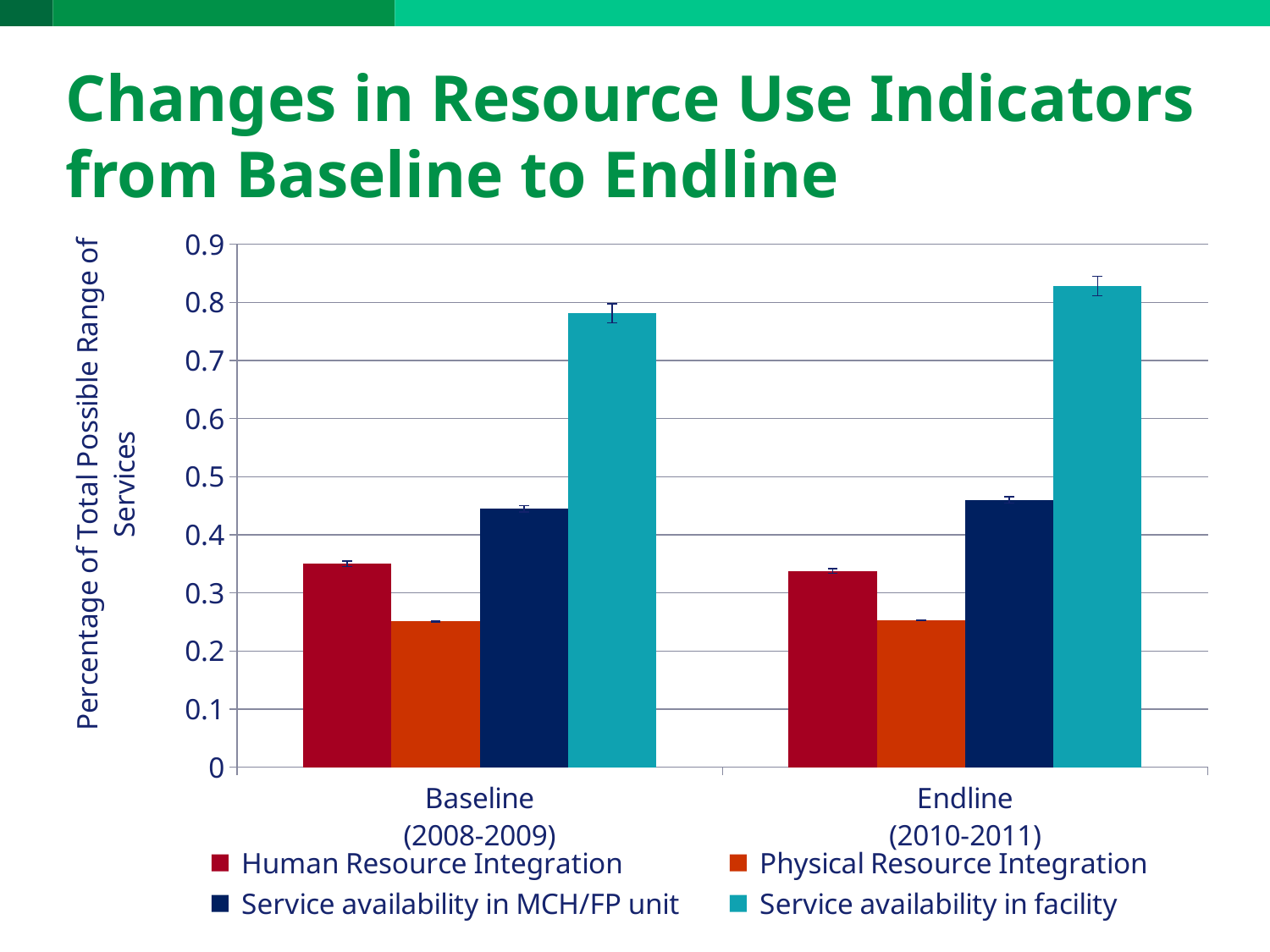
Which series has the highest value at Baseline (2008-2009)? Service availability in facility Is the value for Service availability in MCH/FP unit at Endline (2010-2011) greater or less than 0.5? less Is the value for Service availability in facility at Baseline (2008-2009) greater or less than 0.7? greater Which is larger for Service availability in facility: the Baseline (2008-2009) value or the Endline (2010-2011) value? Endline (2010-2011) How many series does the legend list? 4 Which series has the lowest value at Endline (2010-2011)? Physical Resource Integration What is the title of the y axis? Percentage of Total Possible Range of Services Is the value for Human Resource Integration at Baseline (2008-2009) greater or less than 0.4? less What kind of chart is shown on the slide? bar chart How many categories are shown on the x axis? 2